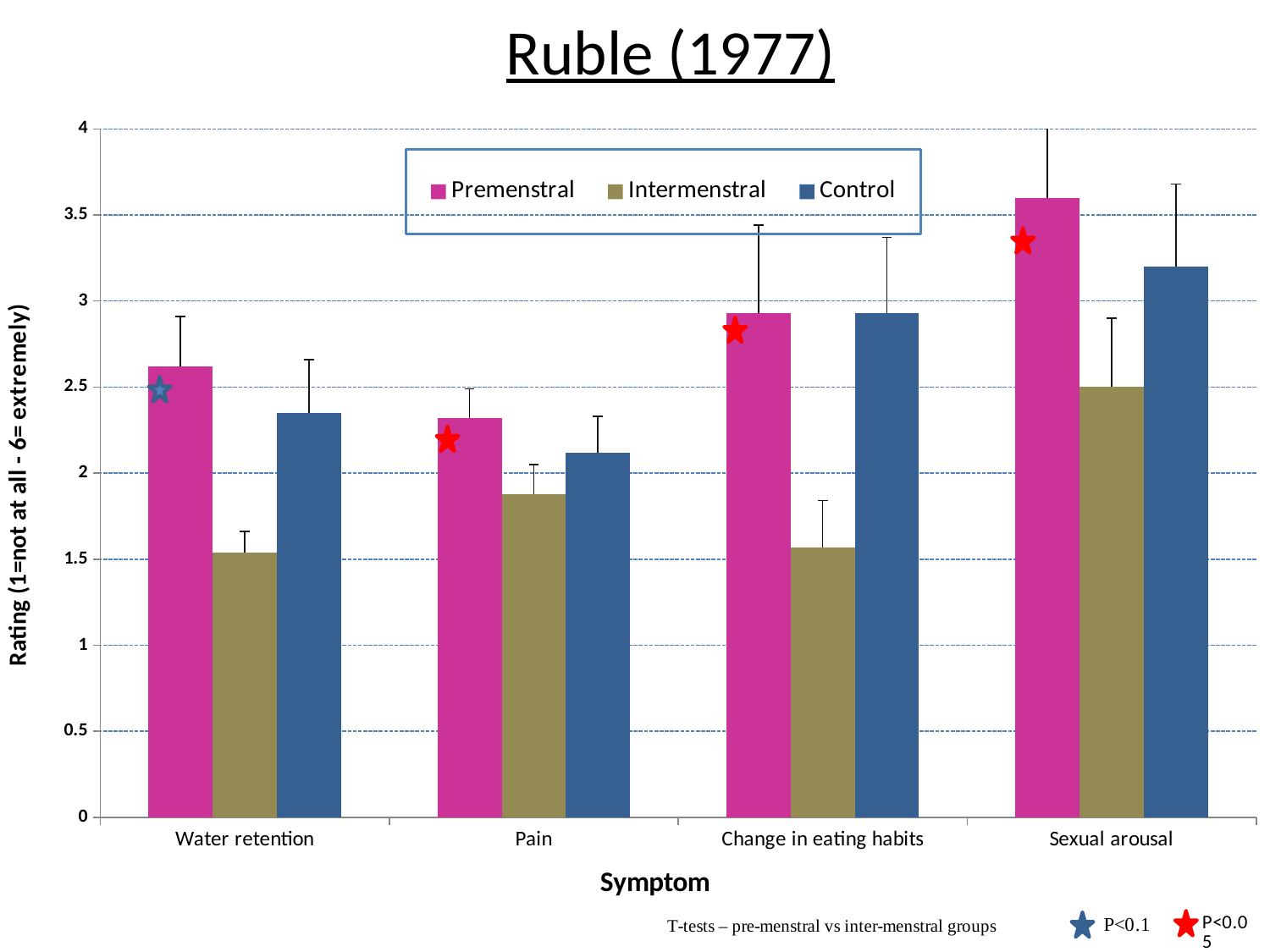
Is the Control rating for Sexual arousal greater or less than 3? greater Is the Intermenstral rating for Water retention greater or less than 2? less How many symptom categories are shown on the x axis? 4 Is the Premenstral rating for Pain greater or less than 2? greater How many series does the legend list? 3 What kind of chart is shown on the slide? bar chart For Water retention, which is larger: the Premenstral rating or the Control rating? Premenstral For Pain, which is larger: the Intermenstral rating or the Control rating? Control Which symptom has the lowest Control rating? Pain Which symptom has the highest Premenstral rating? Sexual arousal What is the title of the chart? Ruble (1977) Which symptom has the highest Intermenstral rating? Sexual arousal